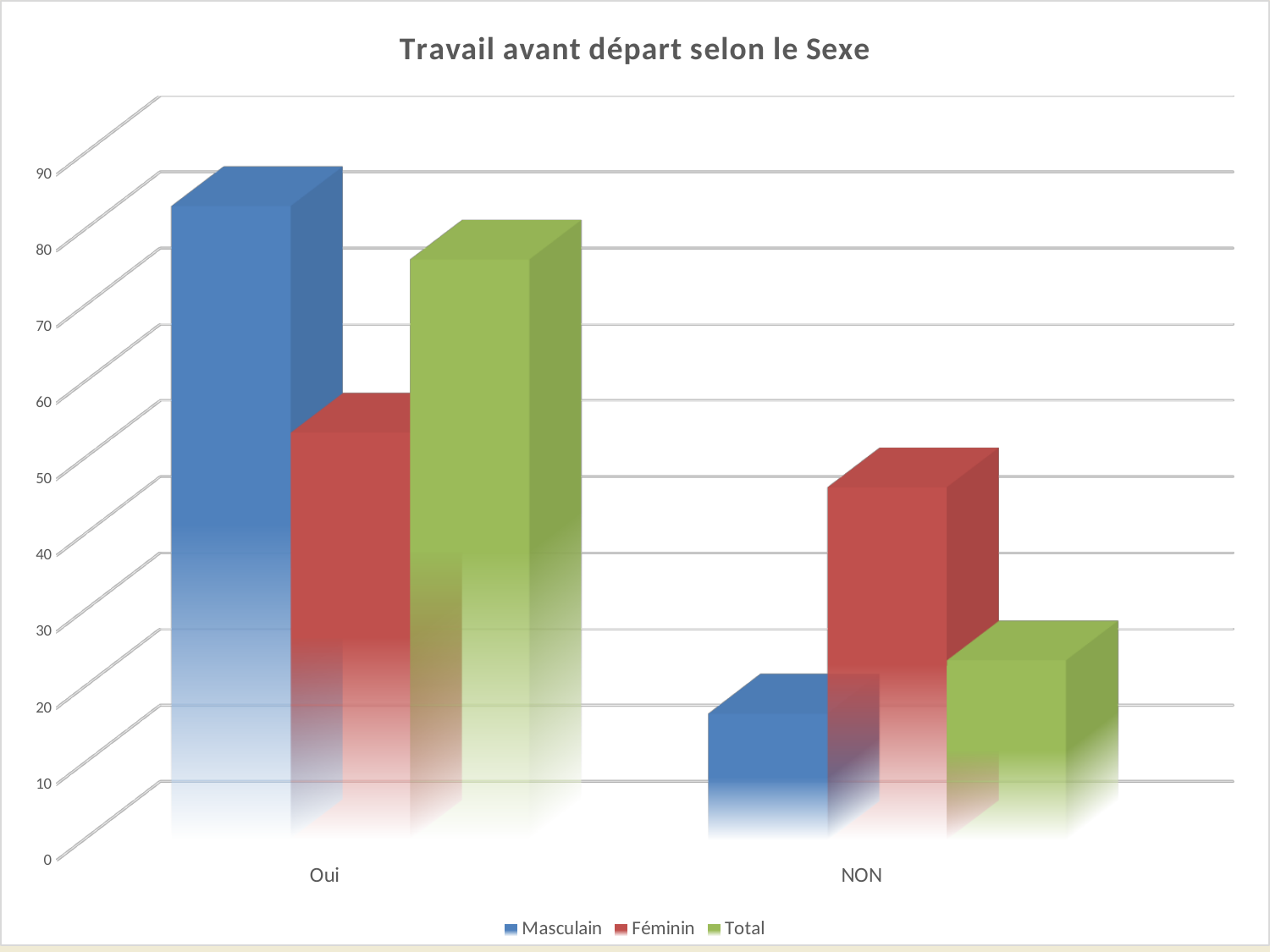
What kind of chart is shown on the slide? bar chart Which series has the highest value for the NON category? Féminin For the Oui category, which is larger: Masculain or Féminin? Masculain Which series has the highest value for the Oui category? Masculain Does the Total series rise or fall from Oui to NON? fall For the NON category, which is larger: Féminin or Total? Féminin How many series does the legend list? 3 Is the Masculain value for NON greater or less than 30? less How many categories are shown on the x axis? 2 What is the title of the chart? Travail avant départ selon le Sexe Which series has the lowest value for the NON category? Masculain Is the Masculain value for Oui greater or less than 70? greater